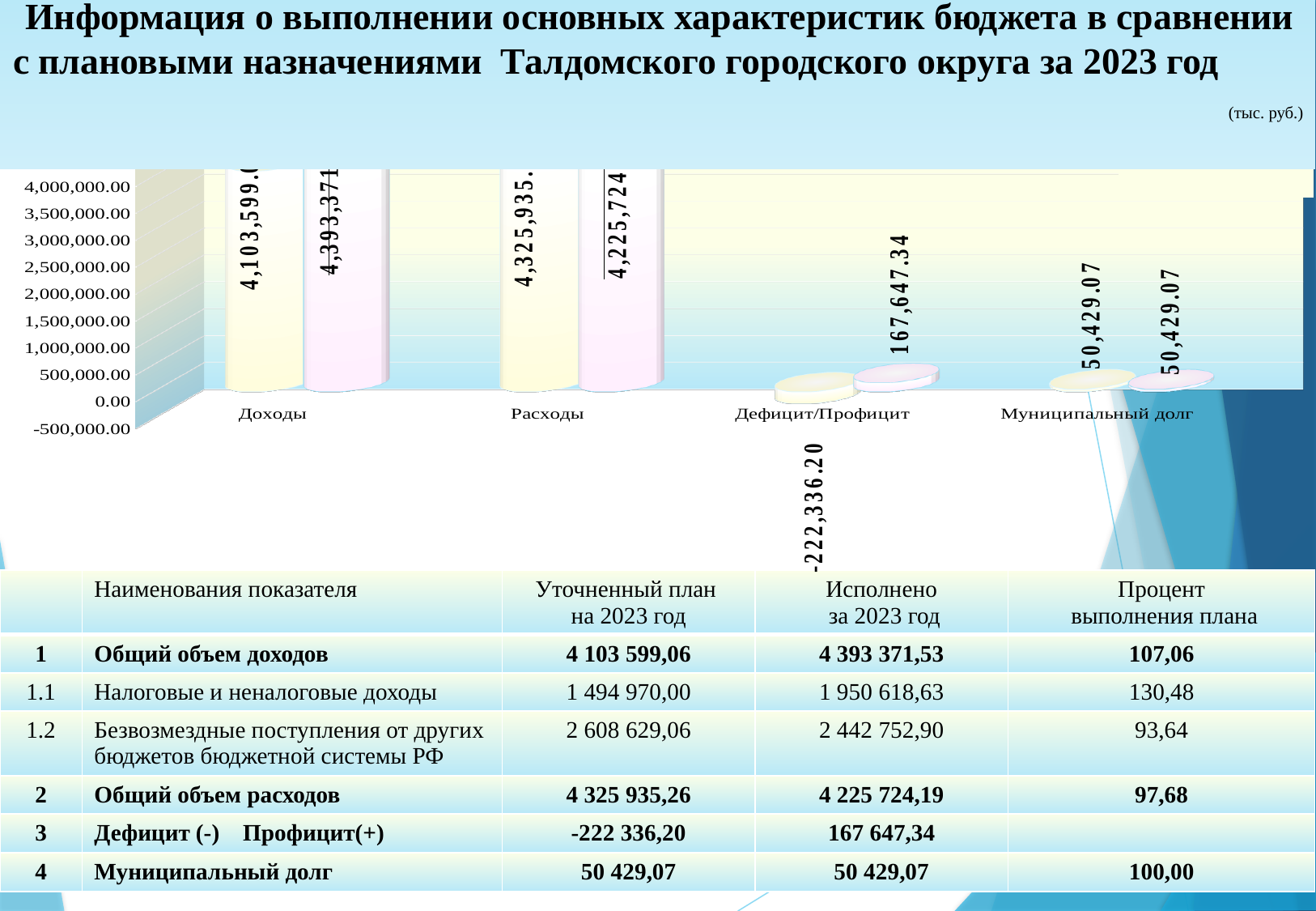
What value is labelled on the bars for Муниципальный долг in the chart? 50,429.07 Is the first bar for Муниципальный долг larger than, smaller than, or equal to the second bar? equal What is the value of the second (executed) bar for Дефицит/Профицит in the chart? 167,647.34 What kind of chart is shown on the slide? bar chart What unit is indicated for the chart values on the slide? тыс. руб. How many categories are shown on the x axis of the chart? 4 Is the value of the second bar for Расходы greater or less than 4,000,000.00? greater Which is larger in the chart: the first bar for Доходы or the first bar for Муниципальный долг? Доходы What is the value of the first (plan) bar for Дефицит/Профицит in the chart? -222,336.20 What is the difference between the two bars for Дефицит/Профицит (167,647.34 and -222,336.20)? 389,983.54 Which category has the lowest plotted value in the chart? Дефицит/Профицит Is the value of the first bar for Доходы greater or less than 4,000,000.00? greater